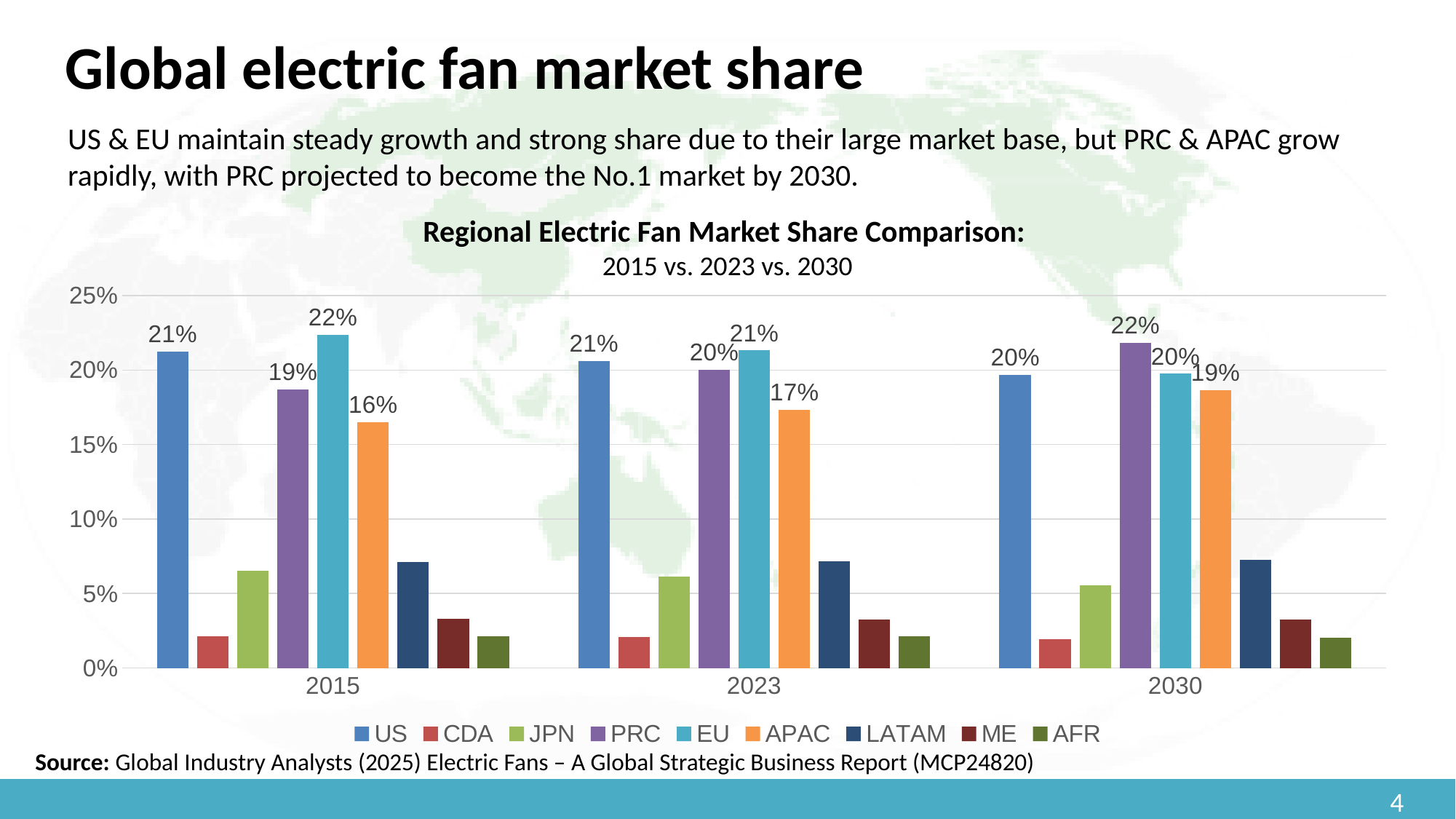
What is the market share for APAC in 2030? 19% In 2030, which is larger: the PRC share or the APAC share? PRC Is the value for LATAM in 2023 greater or less than 10%? less How many year groups are shown on the x axis? 3 Does the APAC market share rise or fall from 2015 to 2030? rise Which region has the highest market share in 2015? EU What is the market share for PRC in 2023? 20% Which region has the highest market share in 2030? PRC How many series does the legend list? 9 What is the difference between the EU and APAC market shares in 2015? 6 percentage points Is the value for JPN in 2015 greater or less than 5%? greater What is the market share for US in 2015? 21%